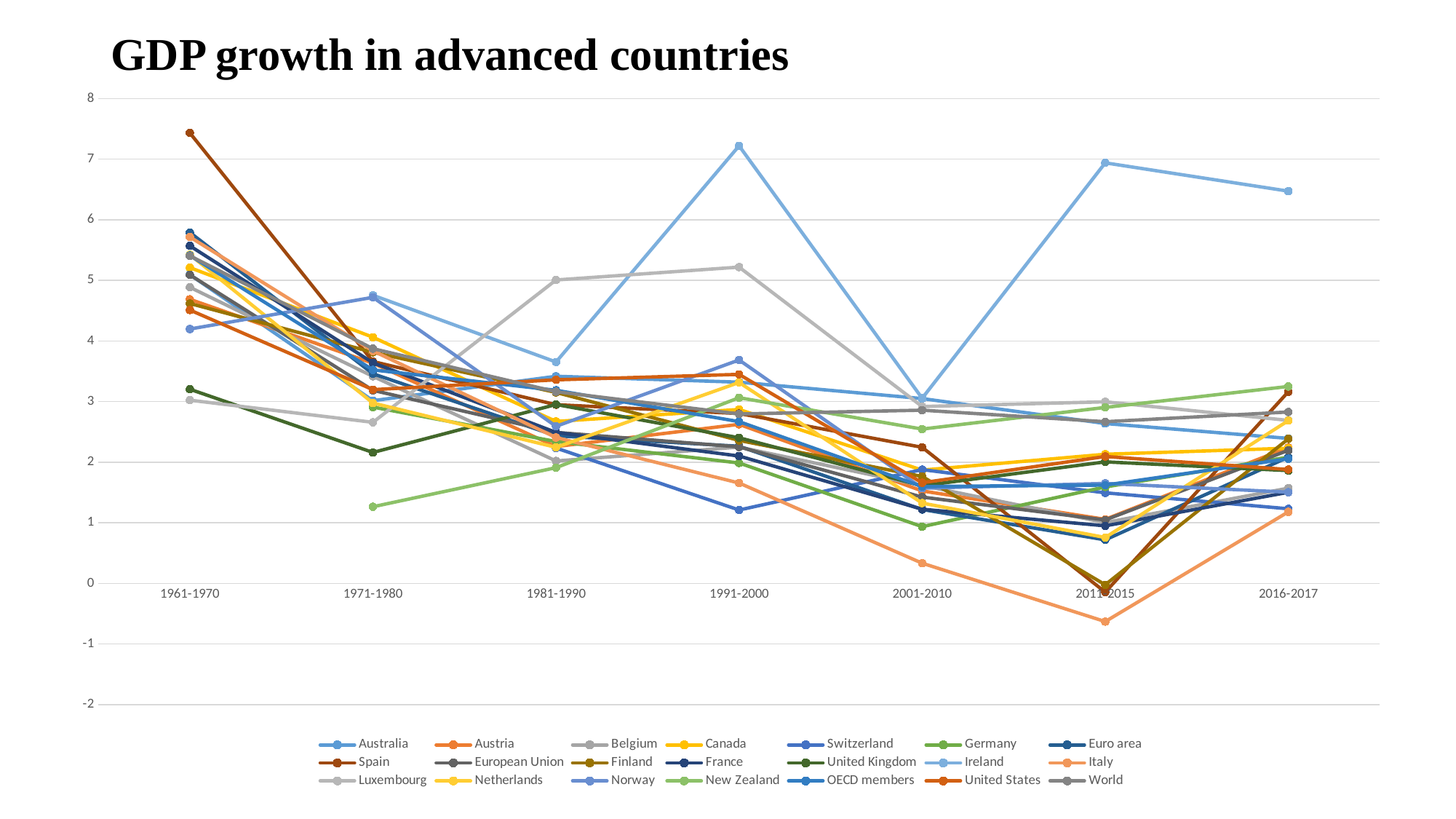
How many time periods are shown along the x axis? 7 Which series has the highest value in the 1991-2000 period? Ireland Is the value for Spain in 1961-1970 greater or less than 7? greater Is the value for Italy in 2011-2015 greater or less than 0? less Which series has the lowest value in the 2011-2015 period? Italy What kind of chart is shown on the slide? line chart Which is larger in 1991-2000, the value for Ireland or the value for Luxembourg? Ireland Does the value for Italy rise or fall from 1961-1970 to 2011-2015? fall How many series does the legend list? 21 Which series has the highest value in the 2016-2017 period? Ireland What is the title of the chart? GDP growth in advanced countries